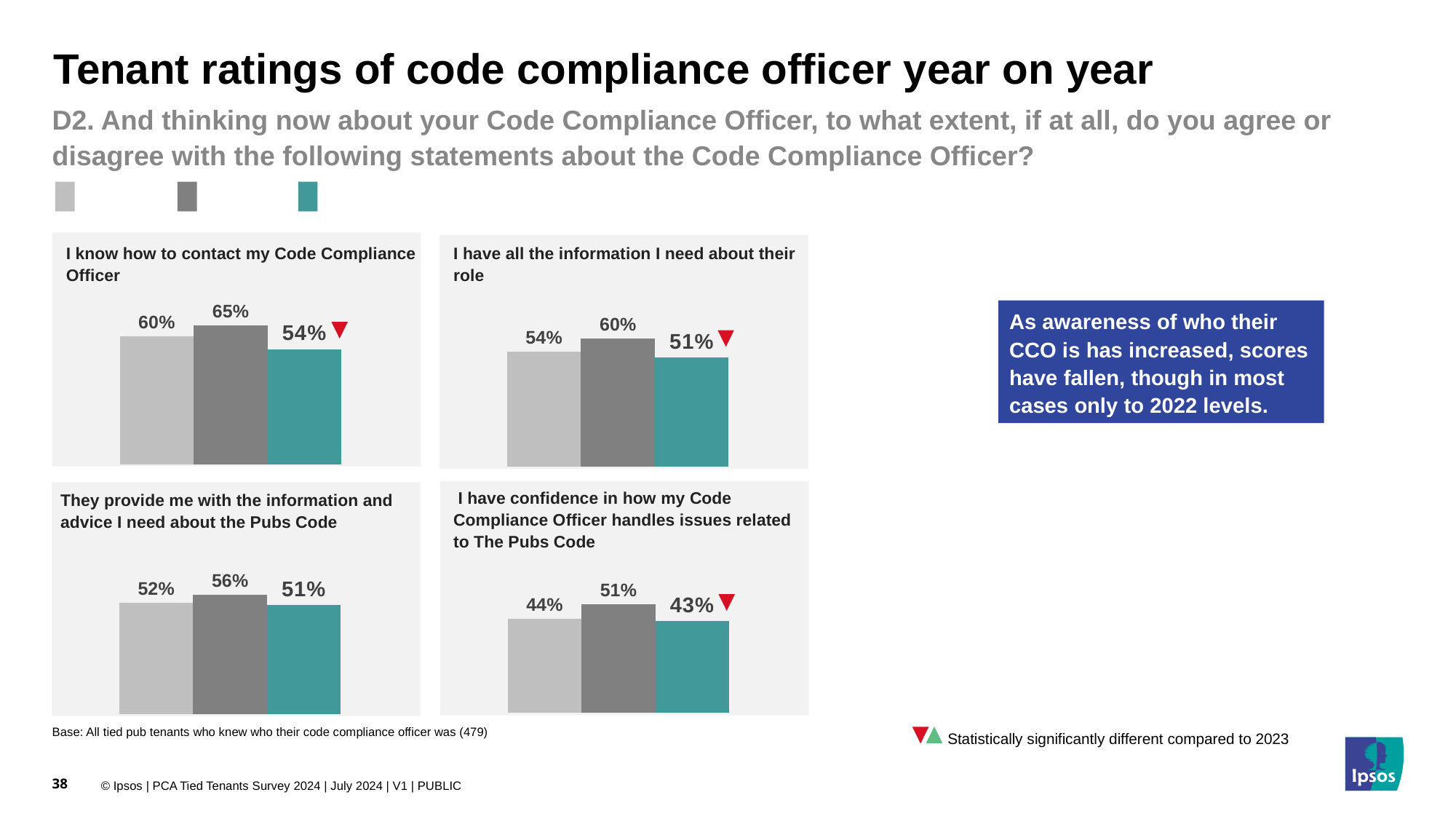
In the chart titled 'They provide me with the information and advice I need about the Pubs Code', what value is shown on the light grey (first) bar? 52% In the chart titled 'I know how to contact my Code Compliance Officer', what value is shown on the teal (third) bar? 54% In the chart titled 'I know how to contact my Code Compliance Officer', what is the difference between the dark grey (middle) bar and the teal (third) bar? 11 percentage points How many bars are shown in each of the four charts on the slide? 3 In the chart titled 'I know how to contact my Code Compliance Officer', which bar has the highest value? The dark grey (middle) bar, 65% What type of chart is used for the four statements on the slide? Bar chart In the chart titled 'I have confidence in how my Code Compliance Officer handles issues related to The Pubs Code', which bar has the lowest value? The teal (third) bar, 43% In the chart titled 'I have confidence in how my Code Compliance Officer handles issues related to The Pubs Code', what value is shown on the teal (third) bar? 43% How many of the four charts show a red downward triangle next to the teal (third) bar? 3 In the chart titled 'They provide me with the information and advice I need about the Pubs Code', which is larger: the light grey (first) bar or the dark grey (middle) bar? The dark grey (middle) bar, 56% In the chart titled 'I have all the information I need about their role', what is the difference between the light grey (first) bar and the teal (third) bar? 3 percentage points In the chart titled 'I have all the information I need about their role', what value is shown on the dark grey (middle) bar? 60%